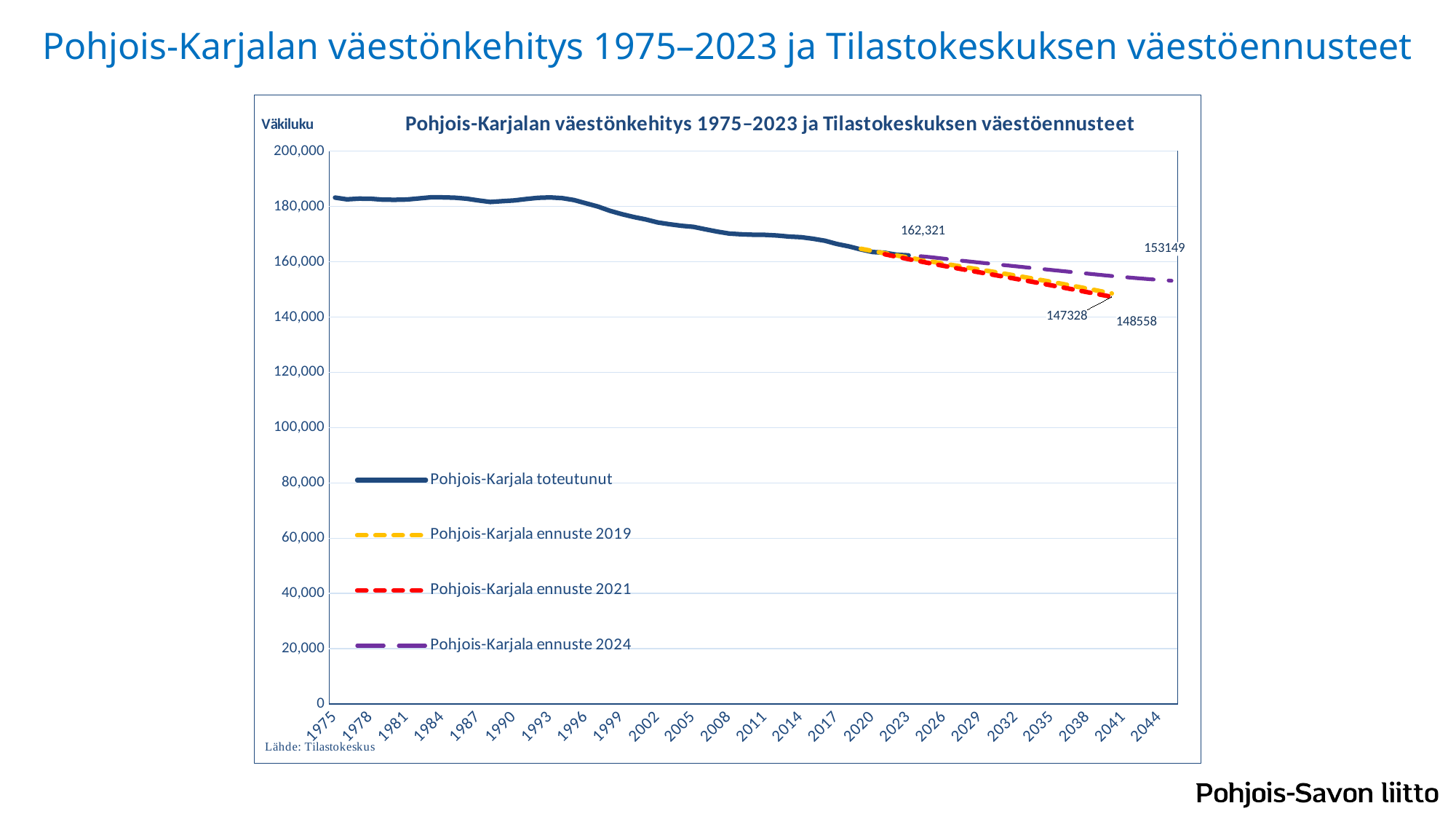
Is the end value of the Pohjois-Karjala ennuste 2024 line greater or less than 160,000? less Is the Pohjois-Karjala toteutunut value in 2017 greater or less than 160,000? greater Does the Pohjois-Karjala toteutunut line rise or fall overall from 1975 to 2023? fall What colour is the Pohjois-Karjala ennuste 2021 line in the legend? red How many series does the legend list? 4 What value is labelled on the Pohjois-Karjala toteutunut line near 2023? 162,321 What is the difference between the labelled value 162,321 and the 2024 forecast end value 153149? 9172 What kind of chart is shown on the slide? line chart Which forecast series ends at the highest value? Pohjois-Karjala ennuste 2024 What is the title of the chart? Pohjois-Karjalan väestönkehitys 1975–2023 ja Tilastokeskuksen väestöennusteet What value is labelled at the end of the Pohjois-Karjala ennuste 2024 line? 153149 Is the Pohjois-Karjala toteutunut value in 1975 greater or less than 180,000? greater